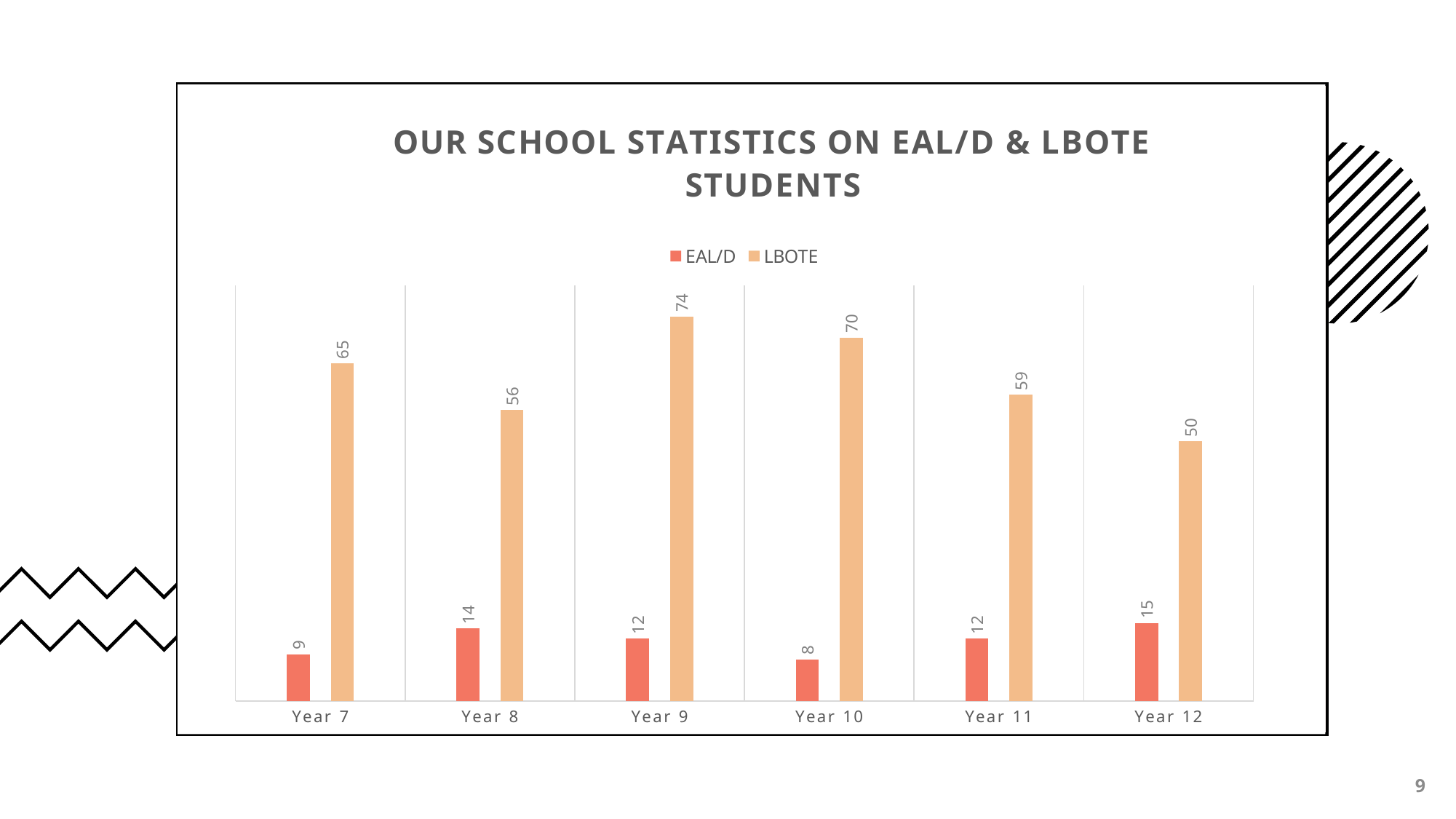
What is the LBOTE value for Year 12? 50 How many year groups are shown on the x axis? 6 How many series does the legend list? 2 Which year group has the highest EAL/D value? Year 12 What is the difference between the LBOTE and EAL/D values for Year 7? 56 What is the title of the chart? OUR SCHOOL STATISTICS ON EAL/D & LBOTE STUDENTS Which year group has the lowest EAL/D value? Year 10 Which is larger, the LBOTE value for Year 8 or the LBOTE value for Year 11? Year 11 What is the EAL/D value for Year 10? 8 What kind of chart is shown on the slide? Bar chart What is the LBOTE value for Year 9? 74 Which year group has the highest LBOTE value? Year 9